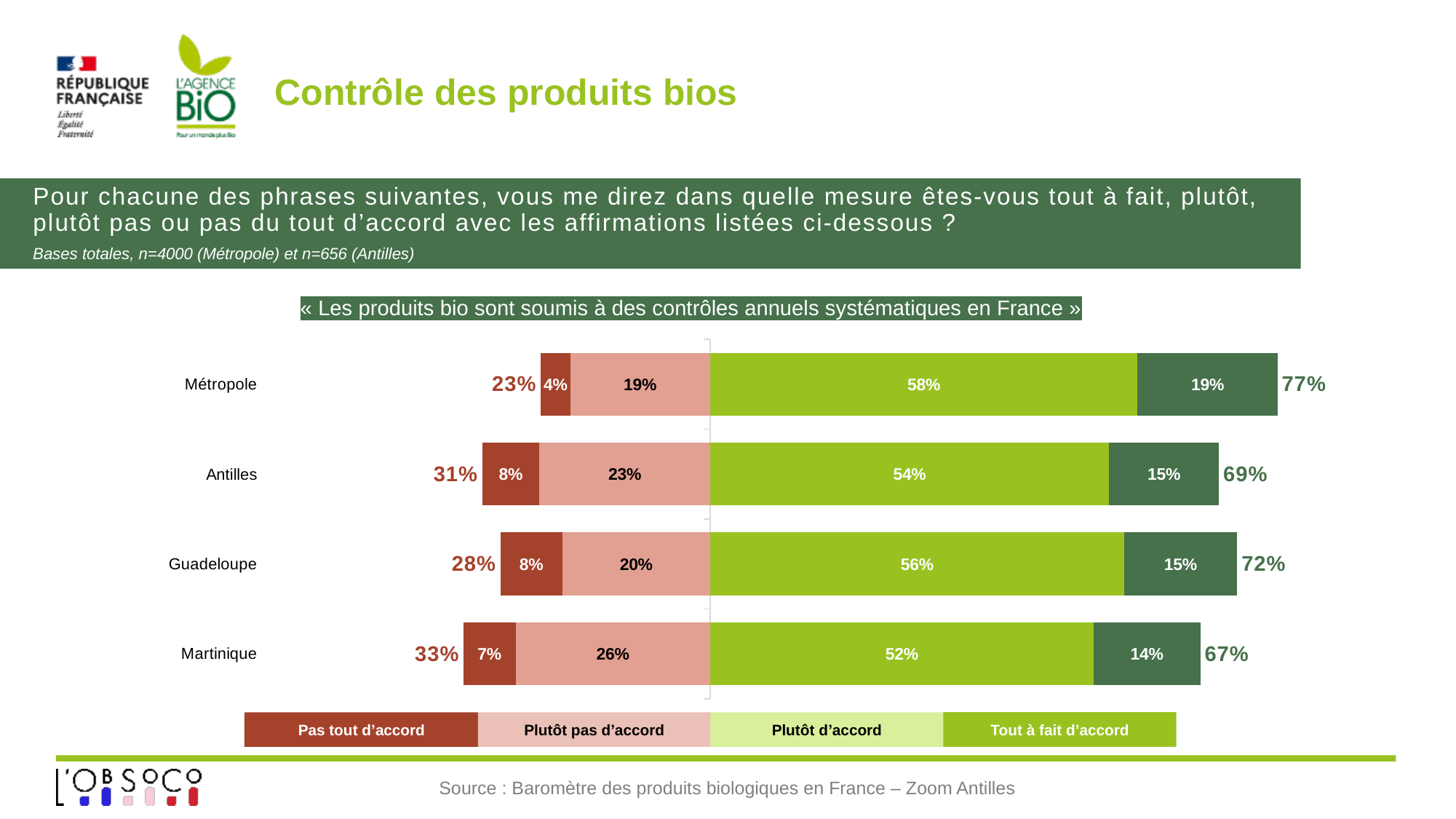
What percentage of Métropole respondents answered "Pas tout d'accord"? 4% What is the "Plutôt d'accord" value for Métropole? 58% Which is larger, the "Plutôt pas d'accord" value for Antilles or for Guadeloupe? Antilles Which category has the lowest total agreement percentage? Martinique What is the difference between the total disagreement percentages of Martinique and Métropole? 10% What is the "Plutôt pas d'accord" value for Martinique? 26% How many categories are shown in the chart? 4 How many series does the legend list? 4 What kind of chart is shown on the slide? Stacked bar chart What is the total agreement percentage shown for Guadeloupe? 72% What statement is the chart about? « Les produits bio sont soumis à des contrôles annuels systématiques en France » Which category has the highest total agreement percentage? Métropole